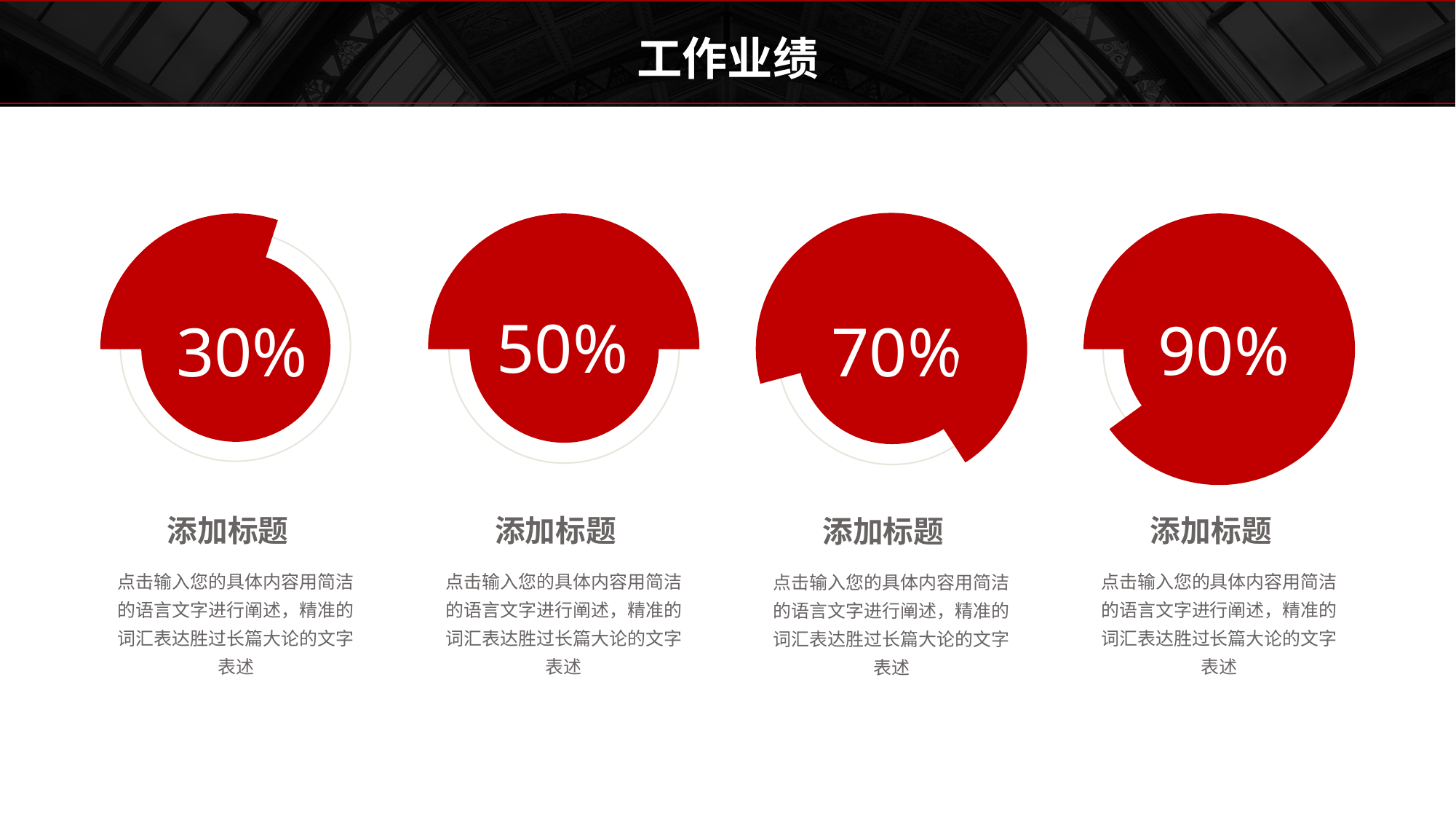
Which is larger, the percentage in the second circle or the third circle? The third circle (70%) What percentage is shown in the second circle from the left? 50% What percentage is shown in the fourth (rightmost) circle? 90% How many circular percentage graphics are on the slide? 4 Do the percentages rise or fall from left to right across the slide? Rise What percentage is shown in the first (leftmost) circle? 30% Which circle shows the lowest percentage? The first (leftmost) circle, 30% What percentage is shown in the third circle from the left? 70% What is the title of the slide? 工作业绩 What is the difference between the percentages in the rightmost and leftmost circles? 60% What is the difference between the percentages in the third and second circles? 20% Which circle shows the highest percentage? The fourth (rightmost) circle, 90%